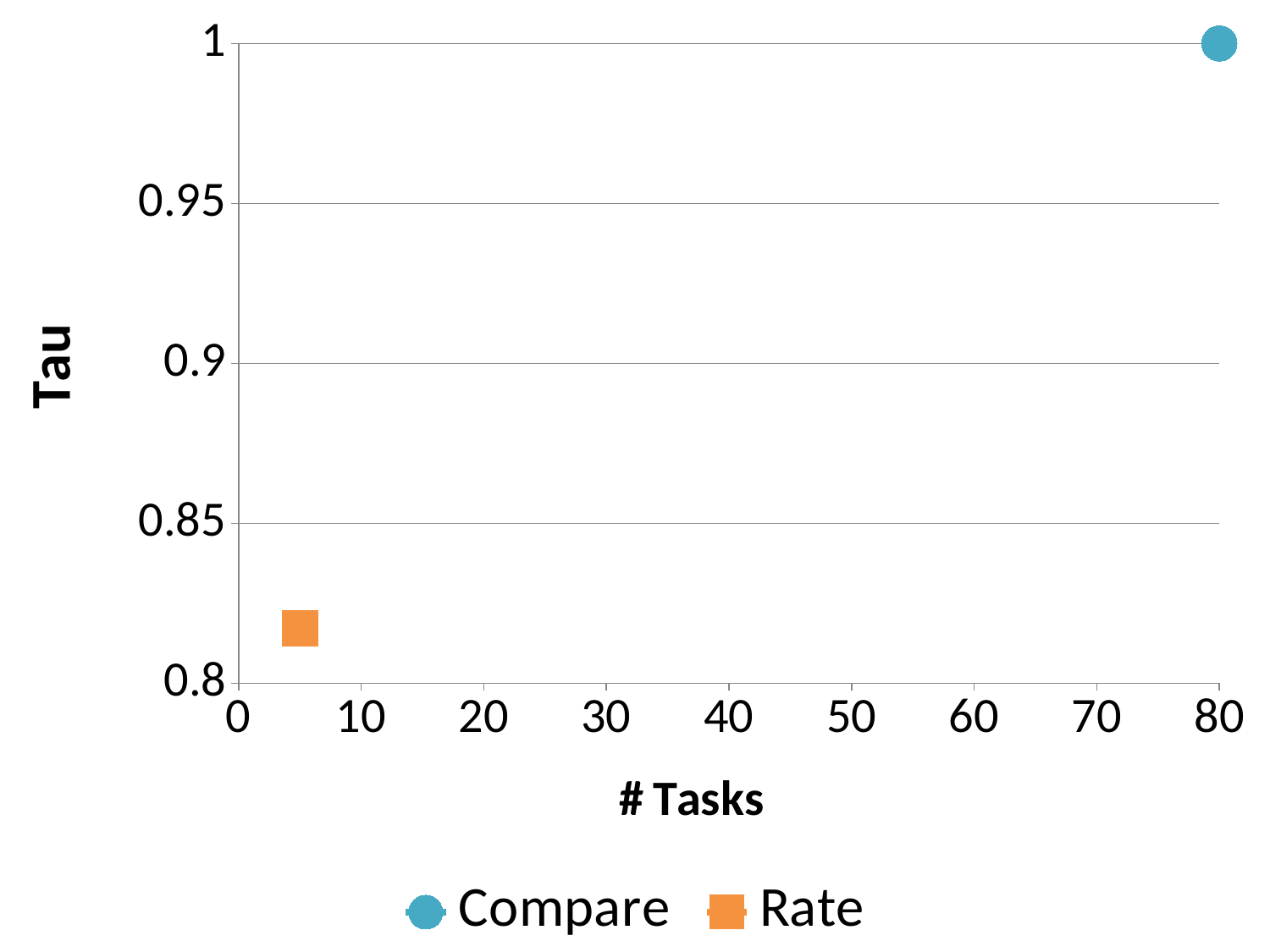
What is the label of the horizontal axis? # Tasks How many series does the legend list? 2 How many data points are plotted on the chart? 2 What is the Tau value for the Compare series? 1 Which series has the lowest Tau value? Rate What is the label of the vertical axis? Tau Is the Tau value for the Rate series greater or less than 0.85? less What kind of chart is shown on the slide? scatter chart Is the number of tasks for the Rate point greater or less than 10? less At how many tasks is the Compare point plotted? 80 Which series has the higher Tau value, Compare or Rate? Compare Is the number of tasks for the Compare point greater or less than 70? greater